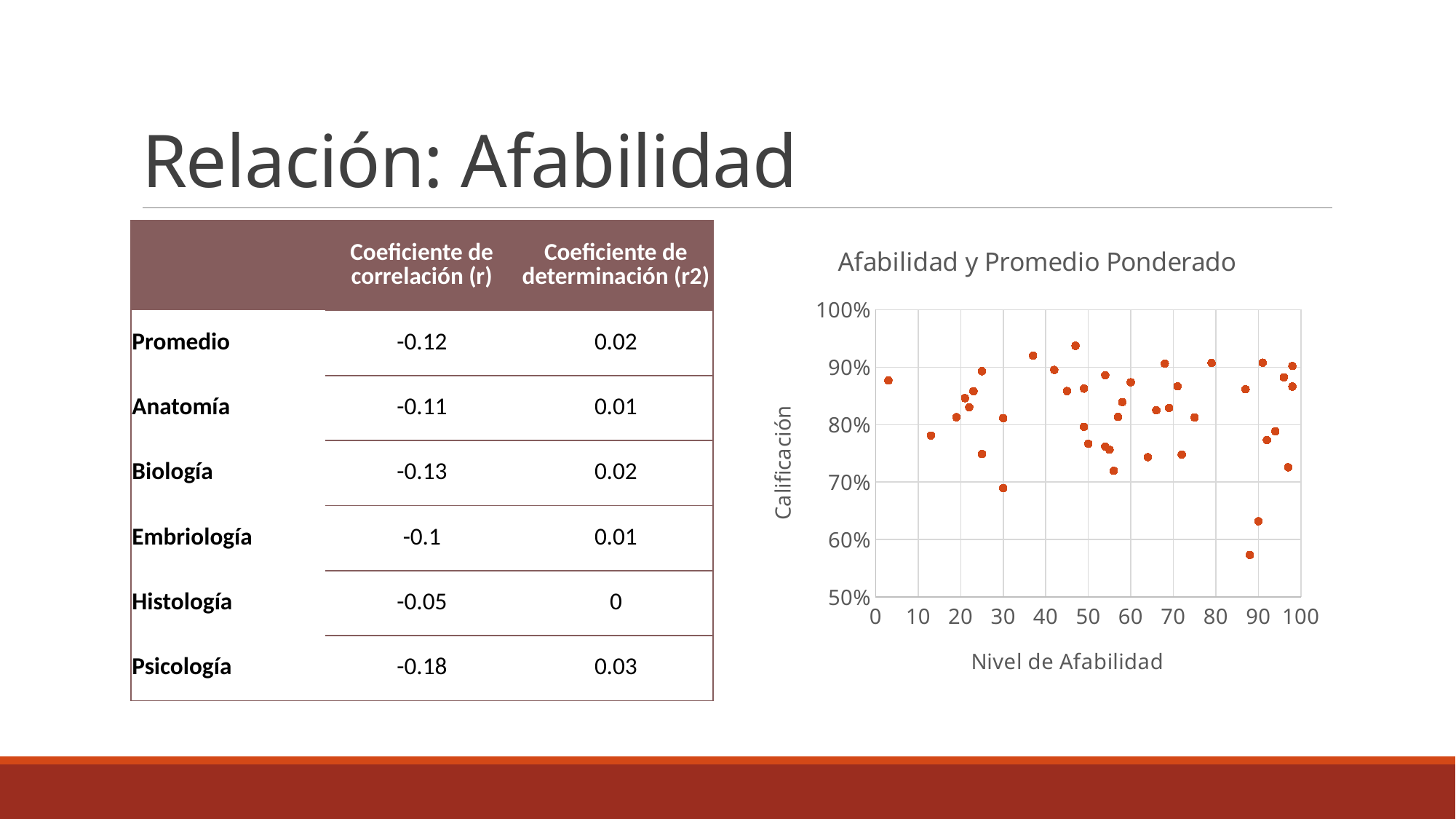
In the chart, is the Calificación of the point at the far left (Nivel de Afabilidad near 0) greater or less than 80%? greater In the chart, is the Nivel de Afabilidad of the point with the highest Calificación greater or less than 40? greater In the chart, is the highest plotted Calificación value greater or less than 90%? greater What kind of chart is shown on the slide? Scatter chart What is the title of the horizontal axis of the chart? Nivel de Afabilidad What is the title of the chart on the slide? Afabilidad y Promedio Ponderado